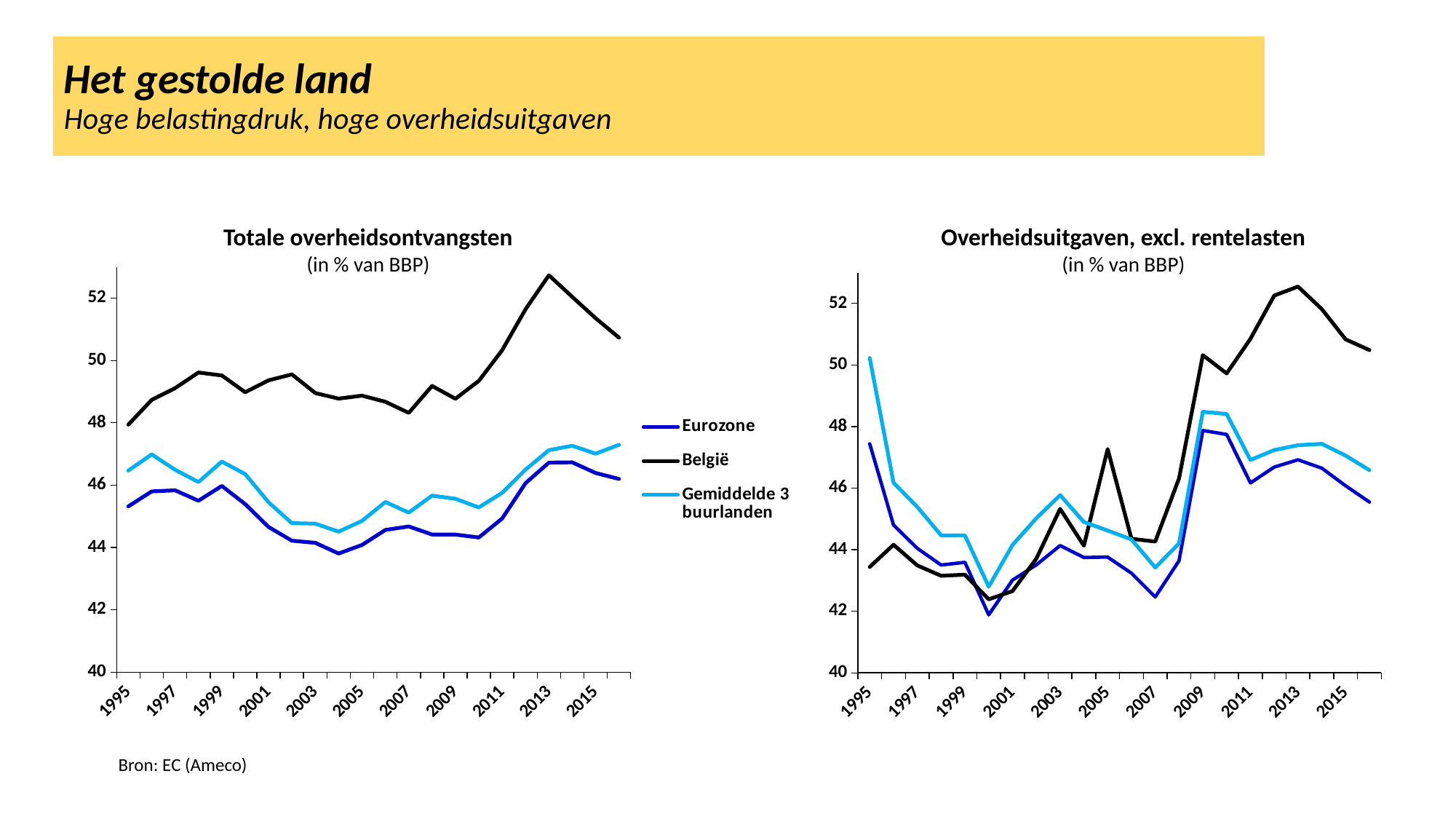
In the 'Totale overheidsontvangsten' chart, is the value for België in 2013 greater or less than 52? greater In the 'Overheidsuitgaven, excl. rentelasten' chart, which series has the lowest value in 2007? Eurozone In the 'Overheidsuitgaven, excl. rentelasten' chart, is the value for Gemiddelde 3 buurlanden in 1995 greater or less than 48? greater What is the title of the chart on the right of the slide? Overheidsuitgaven, excl. rentelasten In the 'Overheidsuitgaven, excl. rentelasten' chart, does the België line rise or fall between 2013 and 2016? fall In the 'Overheidsuitgaven, excl. rentelasten' chart, is the value for België in 2013 greater or less than 52? greater In the 'Totale overheidsontvangsten' chart, does the België line rise or fall between 2010 and 2013? rise In the 'Overheidsuitgaven, excl. rentelasten' chart, which is larger in 2005: België or Eurozone? België How many series does the legend list for the charts? 3 What kind of chart is the 'Totale overheidsontvangsten' chart? line chart In the 'Totale overheidsontvangsten' chart, which series has the highest value in 2013? België